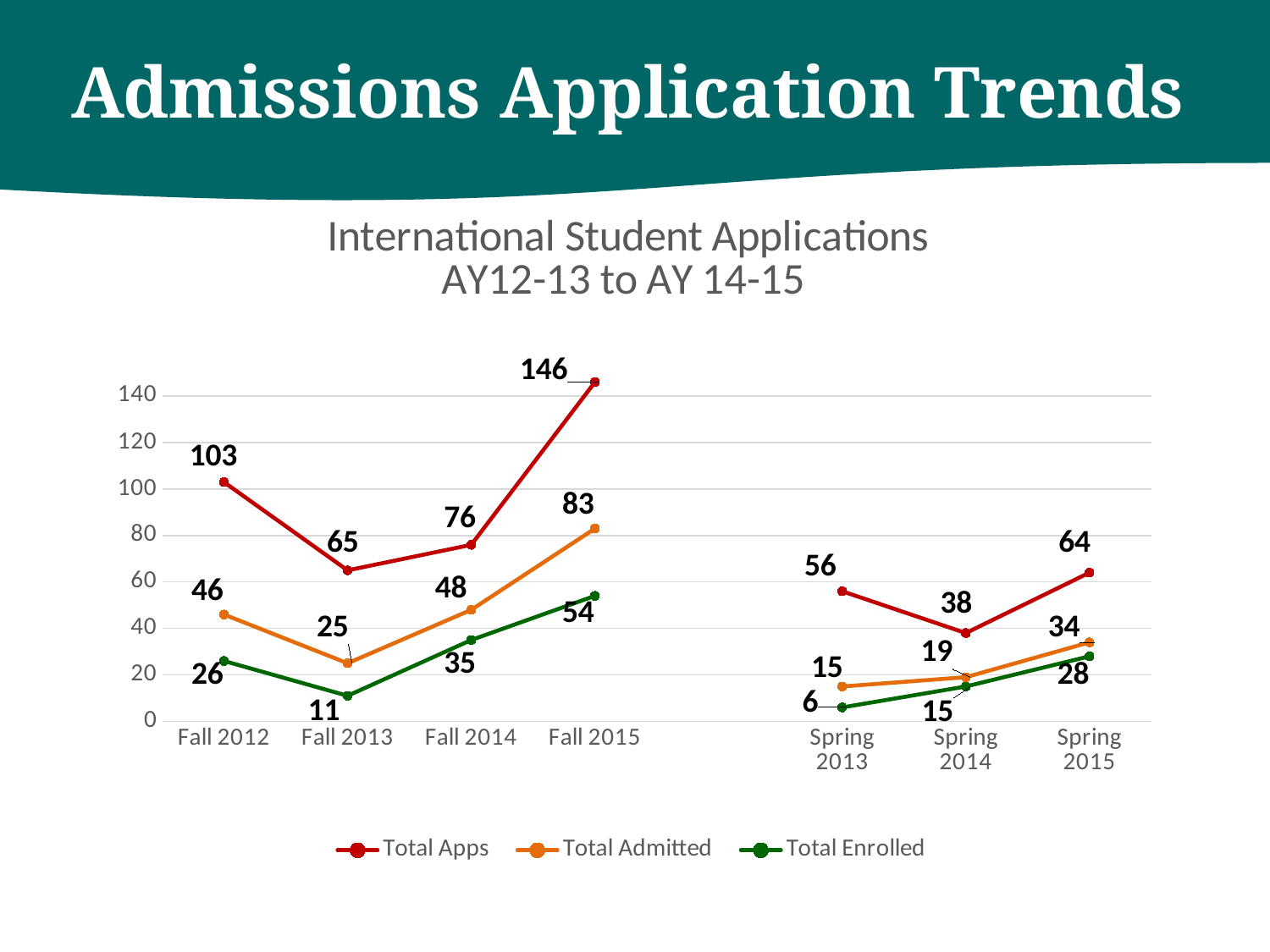
Which is larger, Total Apps for Fall 2012 or Total Apps for Fall 2014? Fall 2012 Does Total Admitted rise or fall from Fall 2013 to Fall 2015? rise What is the value of Total Admitted for Fall 2013? 25 What is the title of the chart? International Student Applications AY12-13 to AY 14-15 Which term has the lowest value for Total Enrolled? Spring 2013 What is the value of Total Apps for Fall 2015? 146 How many terms are shown on the x axis? 7 What is the difference between Total Apps and Total Admitted for Fall 2015? 63 What kind of chart is shown on the slide? line chart Which term has the highest value for Total Apps? Fall 2015 How many series does the legend list? 3 What is the value of Total Enrolled for Spring 2013? 6